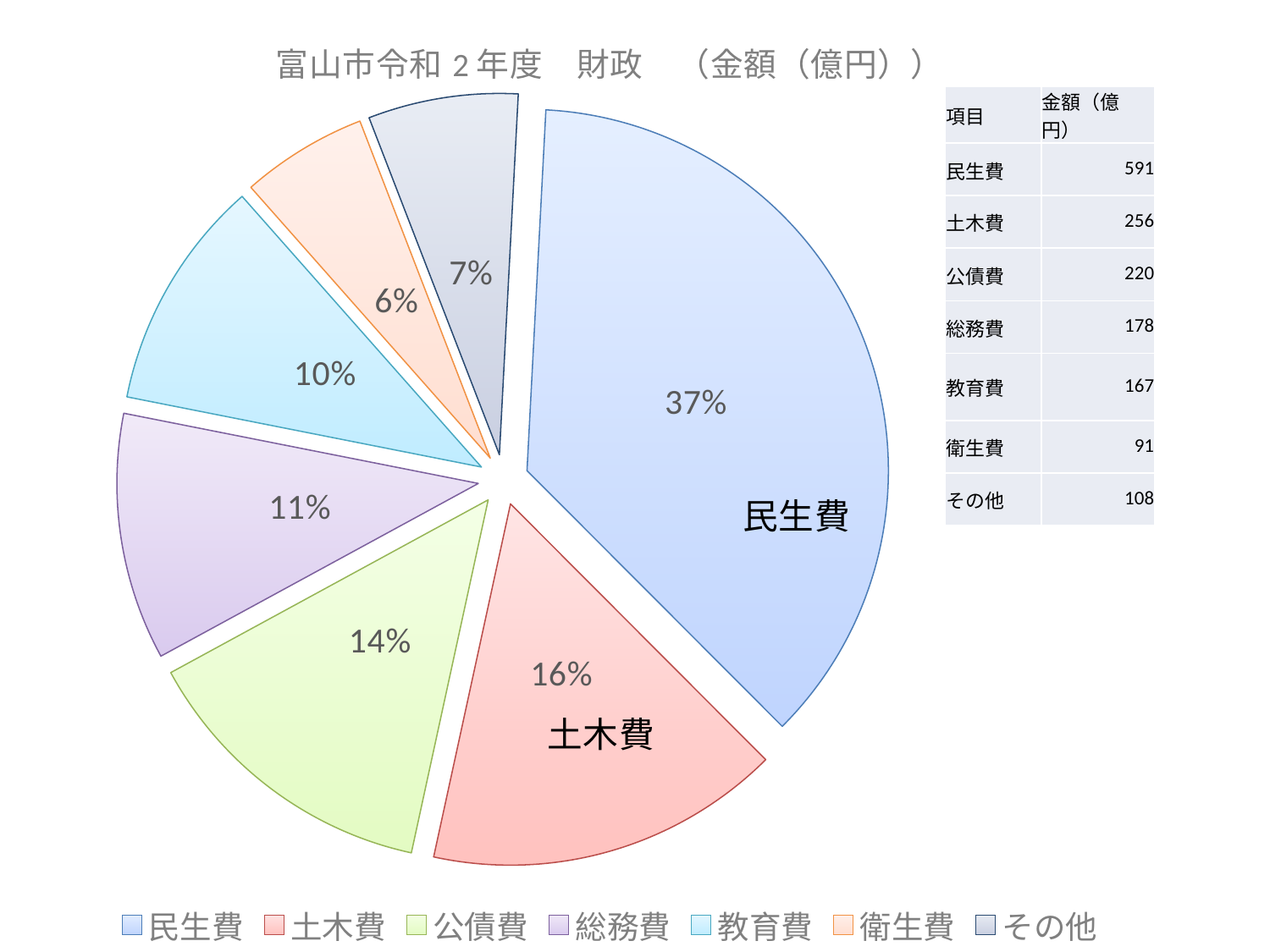
What share of the pie does 民生費 represent? 37% What share of the pie does 衛生費 represent? 6% How many categories does the pie chart show? 7 What is the difference in percentage points between the shares of 民生費 and 土木費? 21 What share of the pie does 土木費 represent? 16% What kind of chart is shown on the slide? pie chart Which category has the smallest slice of the pie? 衛生費 According to the table on the slide, what is the amount (億円) for 公債費? 220 Which is larger, the share for 公債費 or the share for 総務費? 公債費 Which category has the largest slice of the pie? 民生費 What is the title of the chart? 富山市令和２年度 財政 （金額（億円））